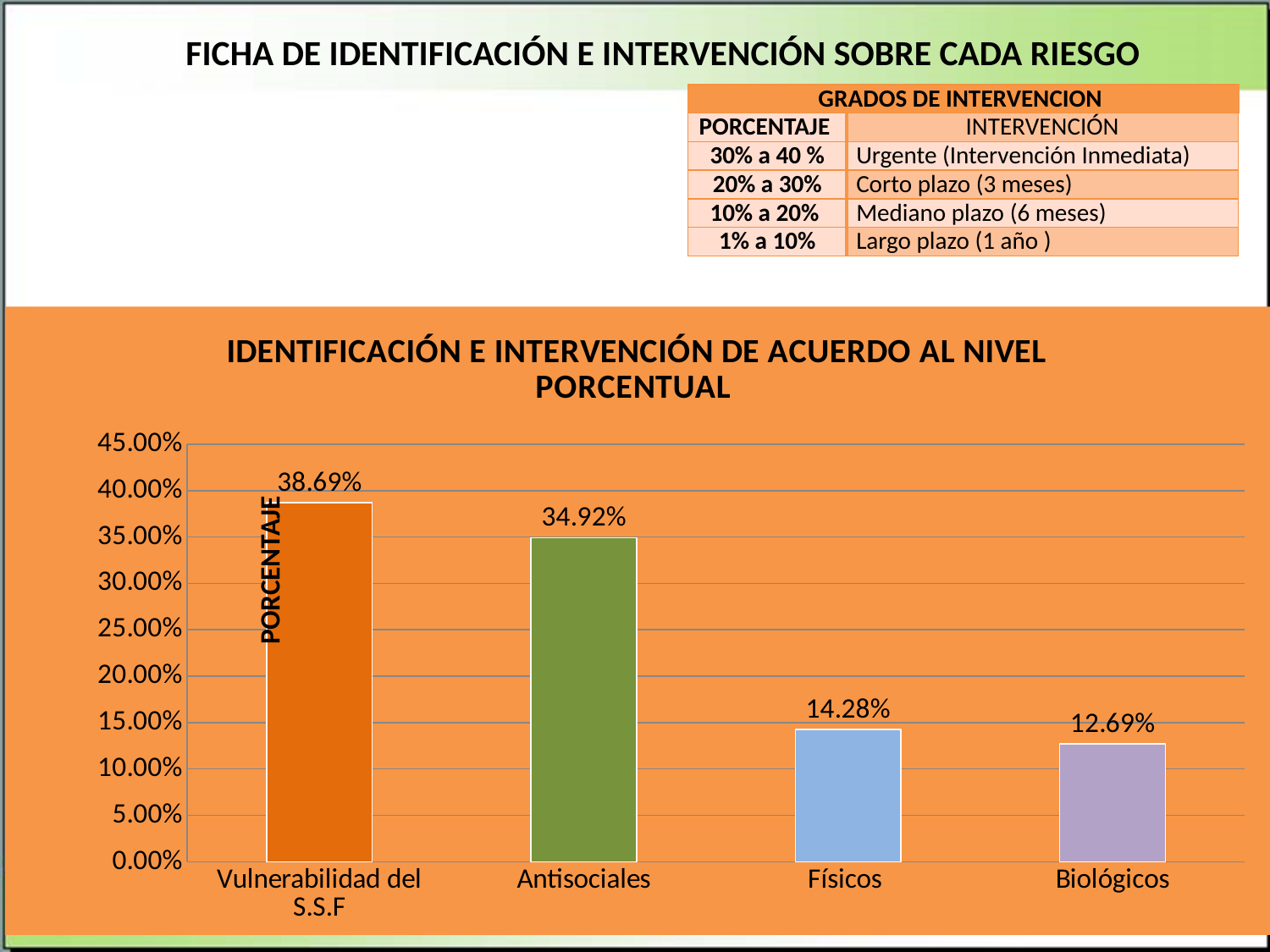
What is the title of the chart? IDENTIFICACIÓN E INTERVENCIÓN DE ACUERDO AL NIVEL PORCENTUAL What is the difference between the values for Físicos and Biológicos? 1.59% What is the value for Antisociales? 34.92% What is the value for Vulnerabilidad del S.S.F? 38.69% Which category has the highest value? Vulnerabilidad del S.S.F What is the value for Biológicos? 12.69% Which category has the lowest value? Biológicos What is the value for Físicos? 14.28% What is the difference between the values for Vulnerabilidad del S.S.F and Antisociales? 3.77% How many categories are shown on the x axis of the chart? 4 Which is larger, the value for Antisociales or the value for Físicos? Antisociales What kind of chart is shown on the slide? Bar chart